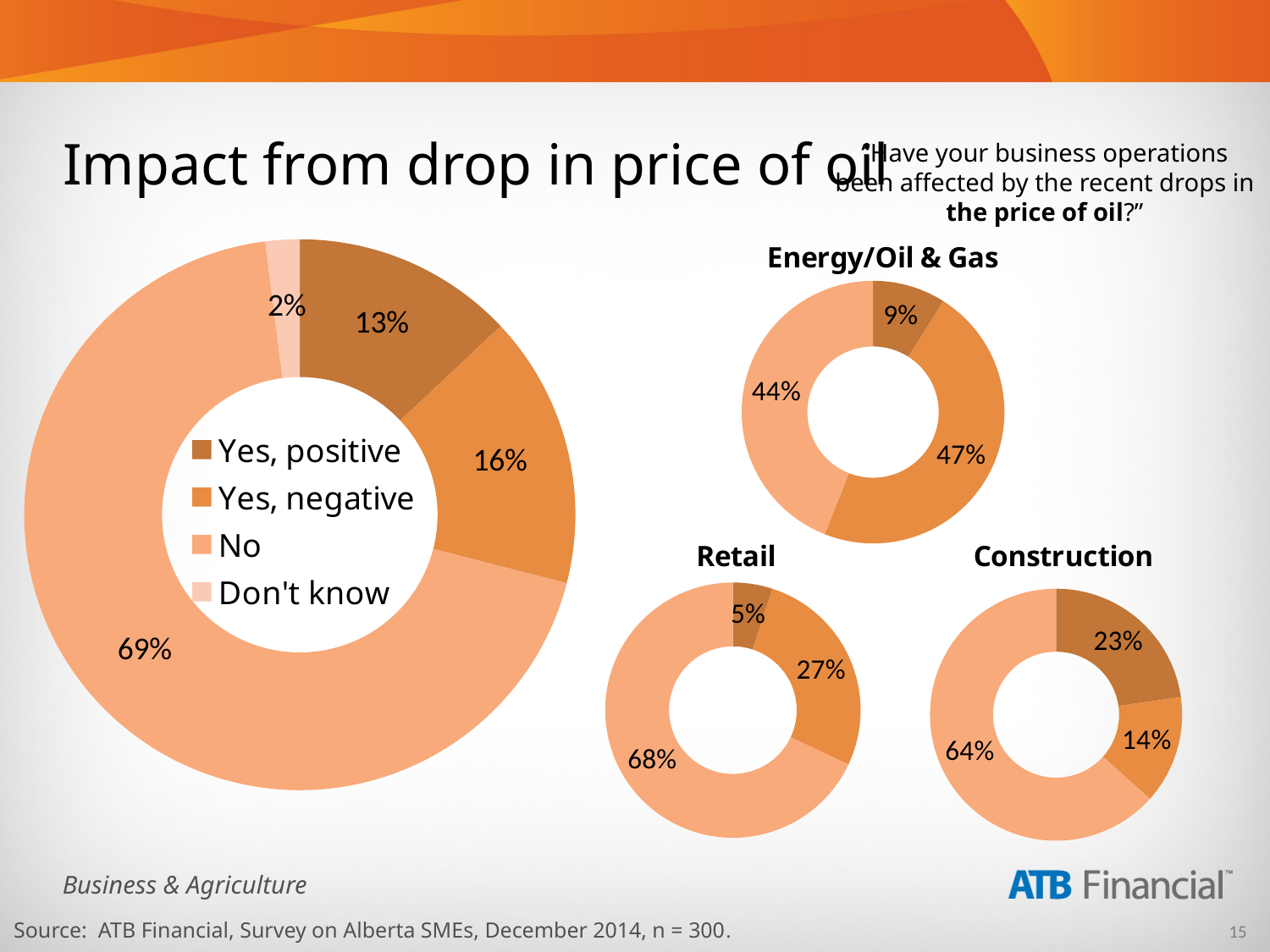
In the large doughnut chart on the left, what percentage answered "Yes, negative"? 16% How many entries does the legend in the large doughnut chart list? 4 Which sector chart shows the highest "Yes, negative" share: Energy/Oil & Gas, Retail, or Construction? Energy/Oil & Gas In the large doughnut chart on the left, which response has the smallest share? Don't know What type of chart is used for the Retail data? Doughnut chart In the Energy/Oil & Gas chart, what is the difference between the "Yes, negative" and "No" shares? 3% In the Retail chart, which response has the largest share? No In the Energy/Oil & Gas chart, what percentage answered "Yes, negative"? 47% In the Construction chart, what percentage answered "Yes, positive"? 23% In the Retail chart, what percentage answered "Yes, positive"? 5% In the Construction chart, which is larger, "Yes, positive" or "Yes, negative"? Yes, positive In the large doughnut chart on the left, what percentage answered "No"? 69%